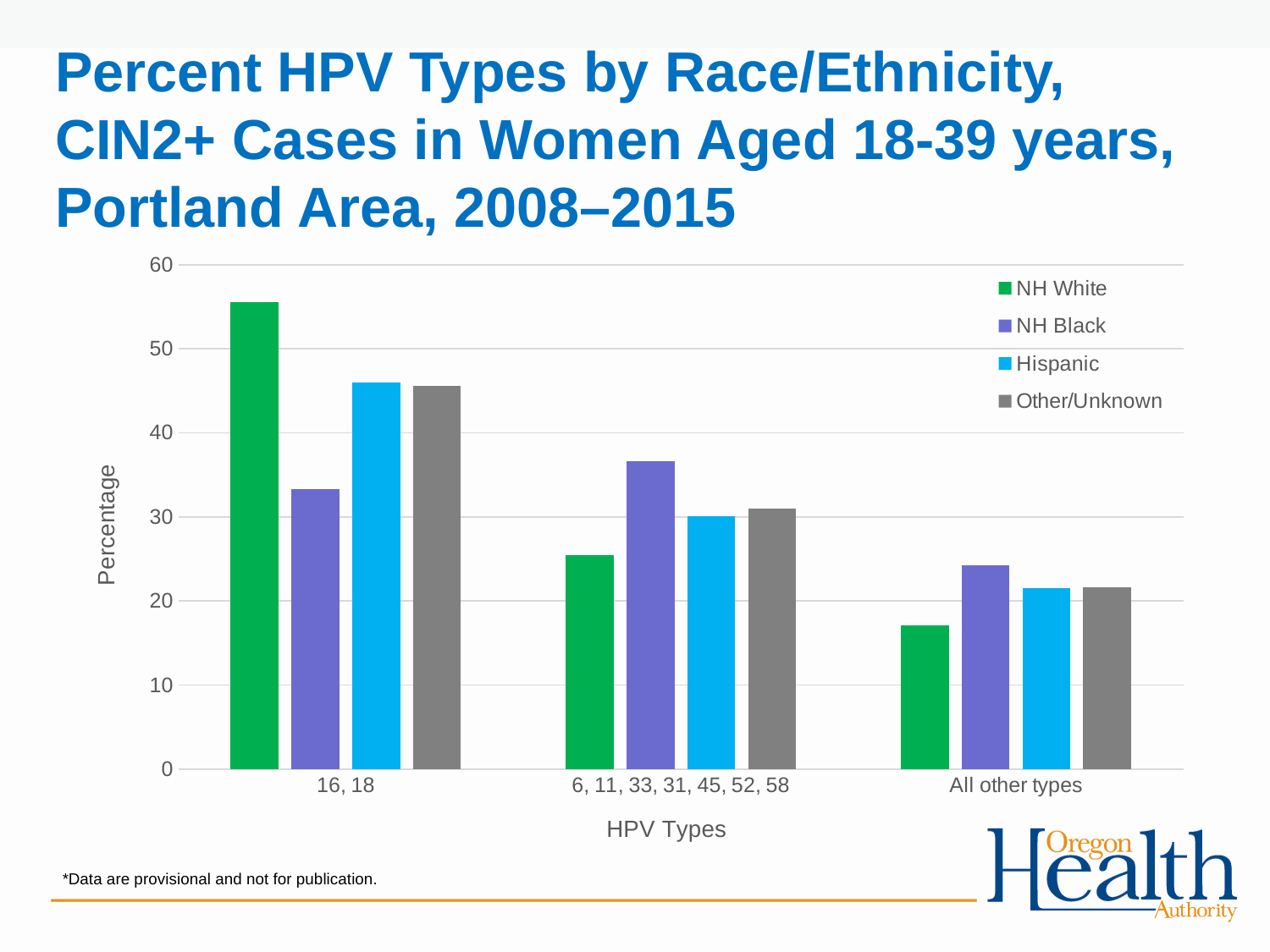
Which race/ethnicity group has the lowest percentage for All other types? NH White Is the NH White value for All other types greater or less than 20? less Is the NH Black value for HPV types 6, 11, 33, 31, 45, 52, 58 greater or less than 30? greater What kind of chart is shown on the slide? bar chart Which race/ethnicity group has the highest percentage for HPV types 6, 11, 33, 31, 45, 52, 58? NH Black Which race/ethnicity group has the lowest percentage for HPV types 16, 18? NH Black How many HPV type categories are shown on the x axis? 3 For HPV types 16, 18, which is larger: the Hispanic value or the NH Black value? Hispanic How many series does the legend list? 4 Which race/ethnicity group has the highest percentage for HPV types 16, 18? NH White What is the label of the y axis? Percentage Is the NH White value for HPV types 16, 18 greater or less than 50? greater